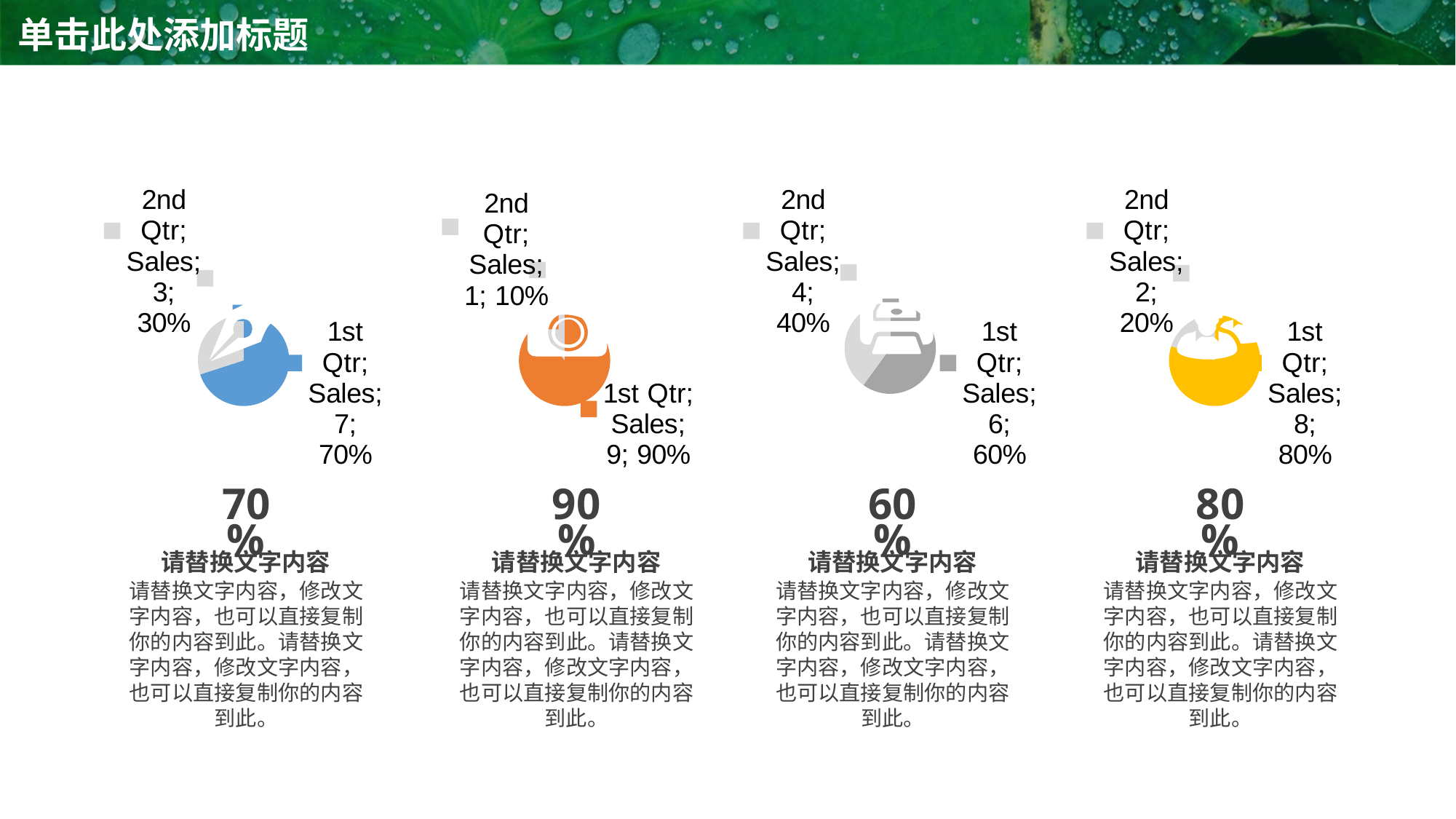
What type of chart is the third chart from the left? Pie chart In the leftmost pie chart, what share of the pie does 2nd Qtr take? 30% In the second pie chart from the left, what share of the pie does 1st Qtr take? 90% In the leftmost pie chart, what is the value for 1st Qtr? 7 In the rightmost pie chart, what is the value for 1st Qtr? 8 In the rightmost pie chart, what share of the pie does 2nd Qtr take? 20% In the second pie chart from the left, what is the value for 2nd Qtr? 1 How many slices does the second pie chart from the left have? 2 In the third pie chart from the left, what is the value for 2nd Qtr? 4 In the rightmost pie chart, what is the difference between the 1st Qtr and 2nd Qtr values? 6 In the leftmost pie chart, which slice is the smallest? 2nd Qtr In the third pie chart from the left, which slice is larger, 1st Qtr or 2nd Qtr? 1st Qtr